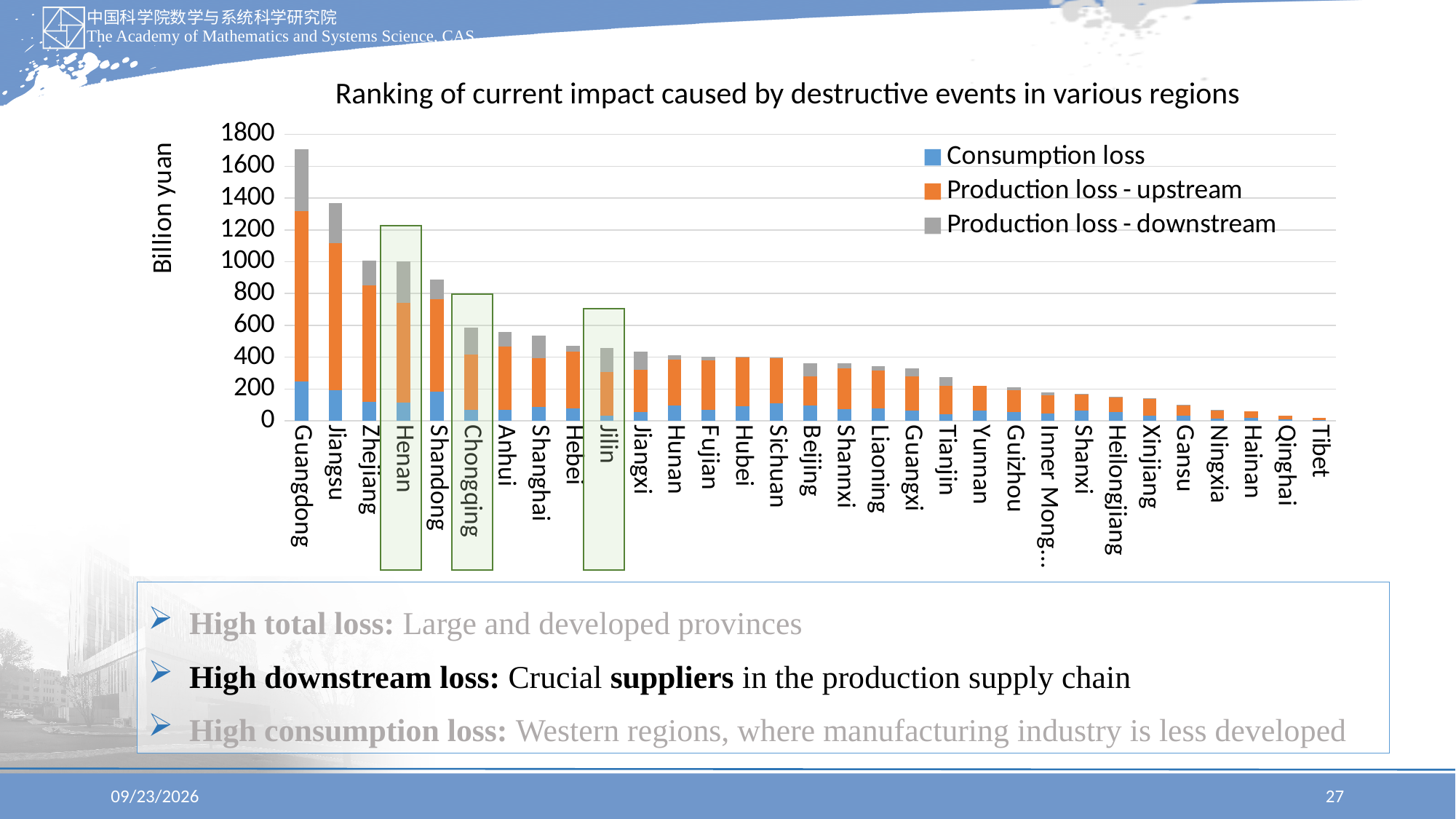
How many series does the legend list? 3 Which region has the highest total loss? Guangdong Is the total loss for Shandong greater or less than 800? greater Do the total losses rise or fall moving from left to right along the x axis? Fall Which has the larger total loss, Shandong or Chongqing? Shandong What kind of chart is shown on the slide? Stacked bar chart Is the total loss for Jiangsu greater or less than 1200? greater Which region has the lowest total loss? Tibet Is the total loss for Guangdong greater or less than 1600? greater How many regions are shown on the x axis of the chart? 31 What is the label on the y axis of the chart? Billion yuan